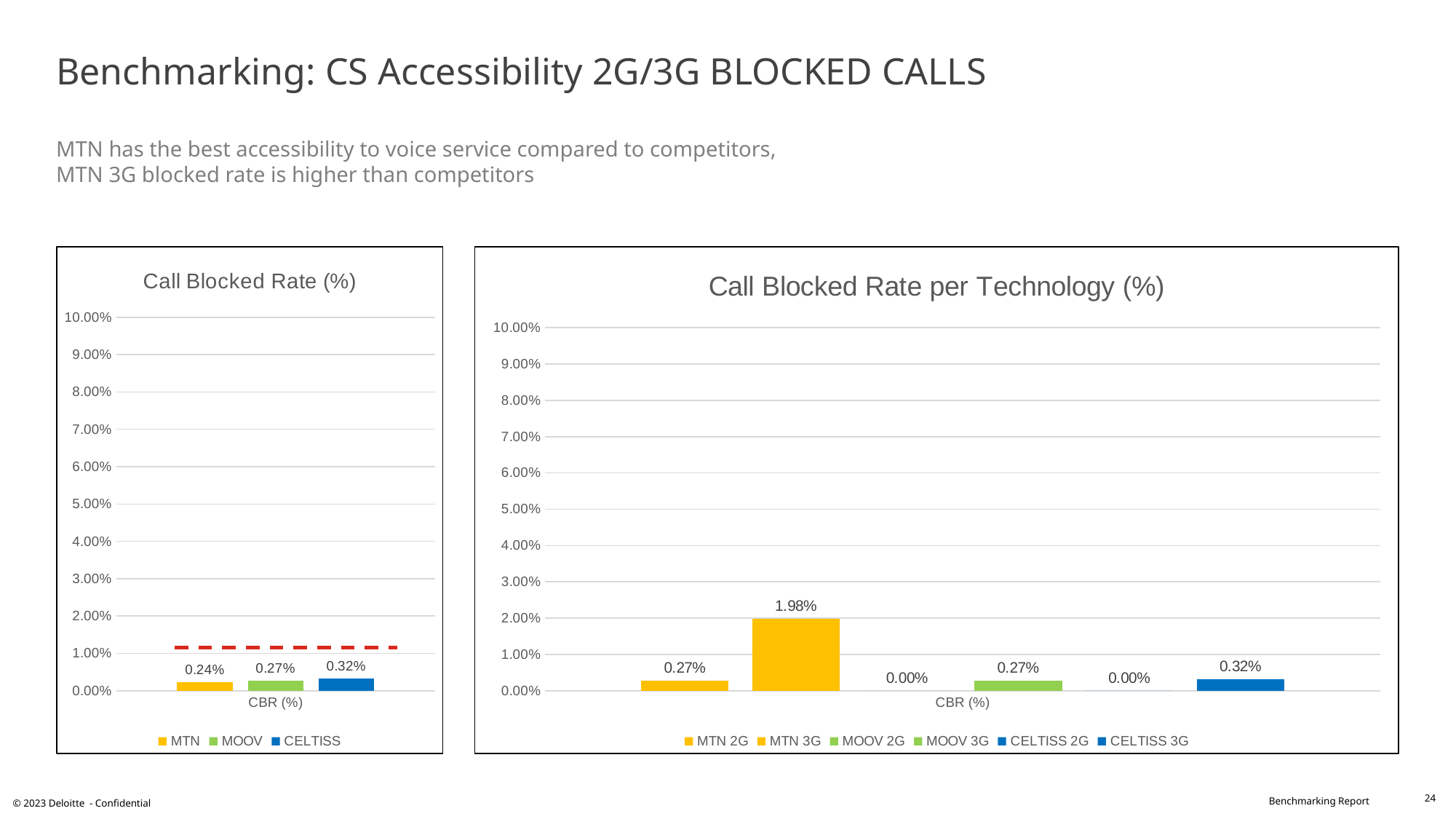
In the 'Call Blocked Rate (%)' chart, what is the value for MTN? 0.24% In the 'Call Blocked Rate (%)' chart, which operator has the lowest call blocked rate? MTN In the 'Call Blocked Rate per Technology (%)' chart, what is the value for CELTISS 2G? 0.00% In the 'Call Blocked Rate (%)' chart, what is the value for CELTISS? 0.32% In the 'Call Blocked Rate per Technology (%)' chart, what is the difference between the MTN 3G and MTN 2G values? 1.71% In the 'Call Blocked Rate (%)' chart, what is the difference between the CELTISS and MTN values? 0.08% In the 'Call Blocked Rate (%)' chart, how many series does the legend list? 3 In the 'Call Blocked Rate per Technology (%)' chart, which series has the highest value? MTN 3G In the 'Call Blocked Rate per Technology (%)' chart, is the value for MTN 3G greater or less than 1.00%? greater In the 'Call Blocked Rate per Technology (%)' chart, what is the value for MTN 3G? 1.98% In the 'Call Blocked Rate per Technology (%)' chart, how many series does the legend list? 6 In the 'Call Blocked Rate (%)' chart, which operator has the highest call blocked rate? CELTISS